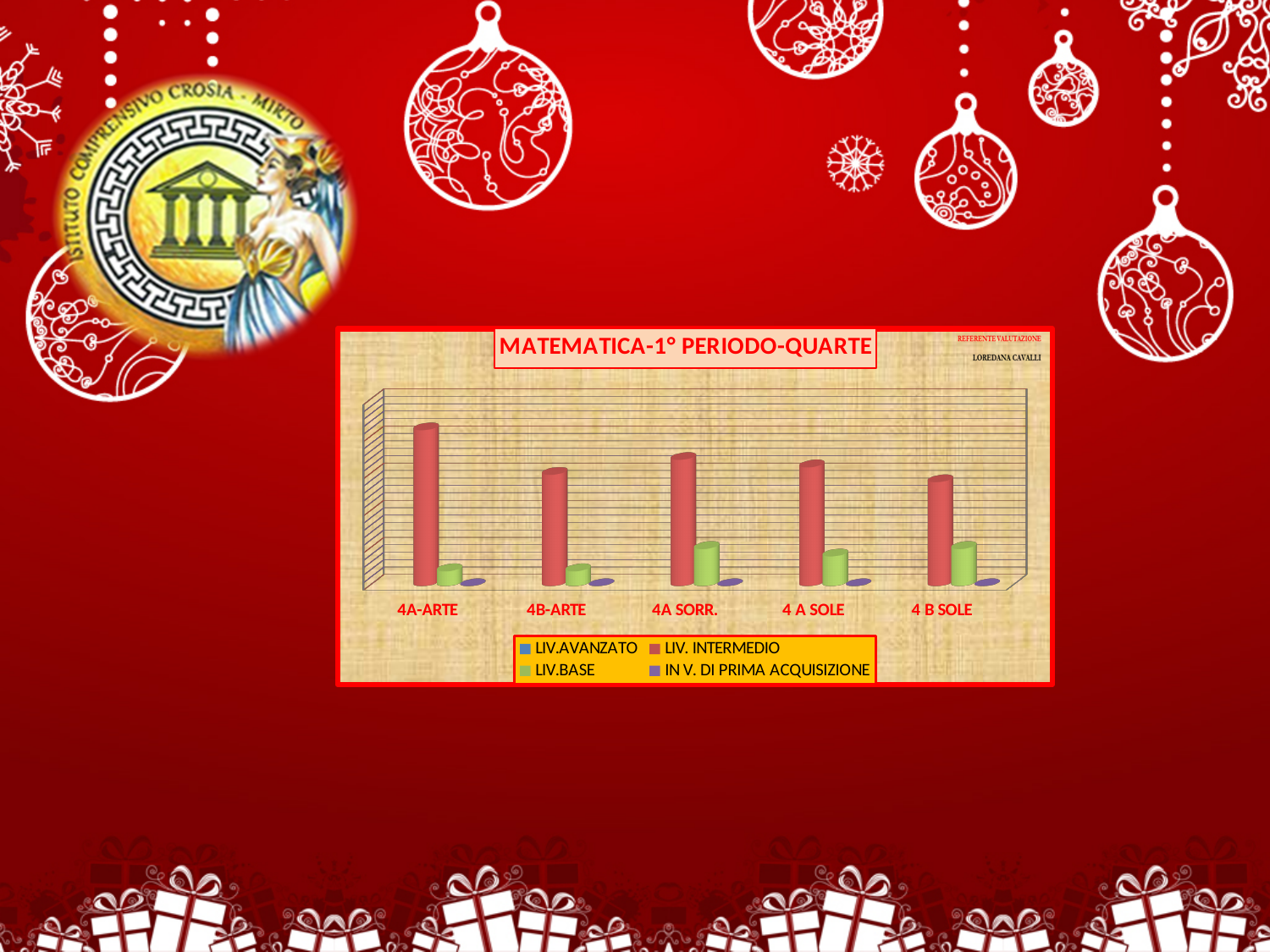
How many series does the chart legend list? 4 What is the title of the chart? MATEMATICA-1° PERIODO-QUARTE What kind of chart is shown on the slide? bar chart How many categories (classes) are shown on the x axis of the chart? 5 Which class has the highest LIV. INTERMEDIO bar? 4A-ARTE Which colour represents LIV.BASE in the chart legend? green Is the LIV. INTERMEDIO bar larger for 4A-ARTE or for 4 B SOLE? 4A-ARTE Is the LIV.BASE bar larger for 4A SORR. or for 4B-ARTE? 4A SORR. Is the LIV. INTERMEDIO bar larger for 4A-ARTE or for 4A SORR.? 4A-ARTE